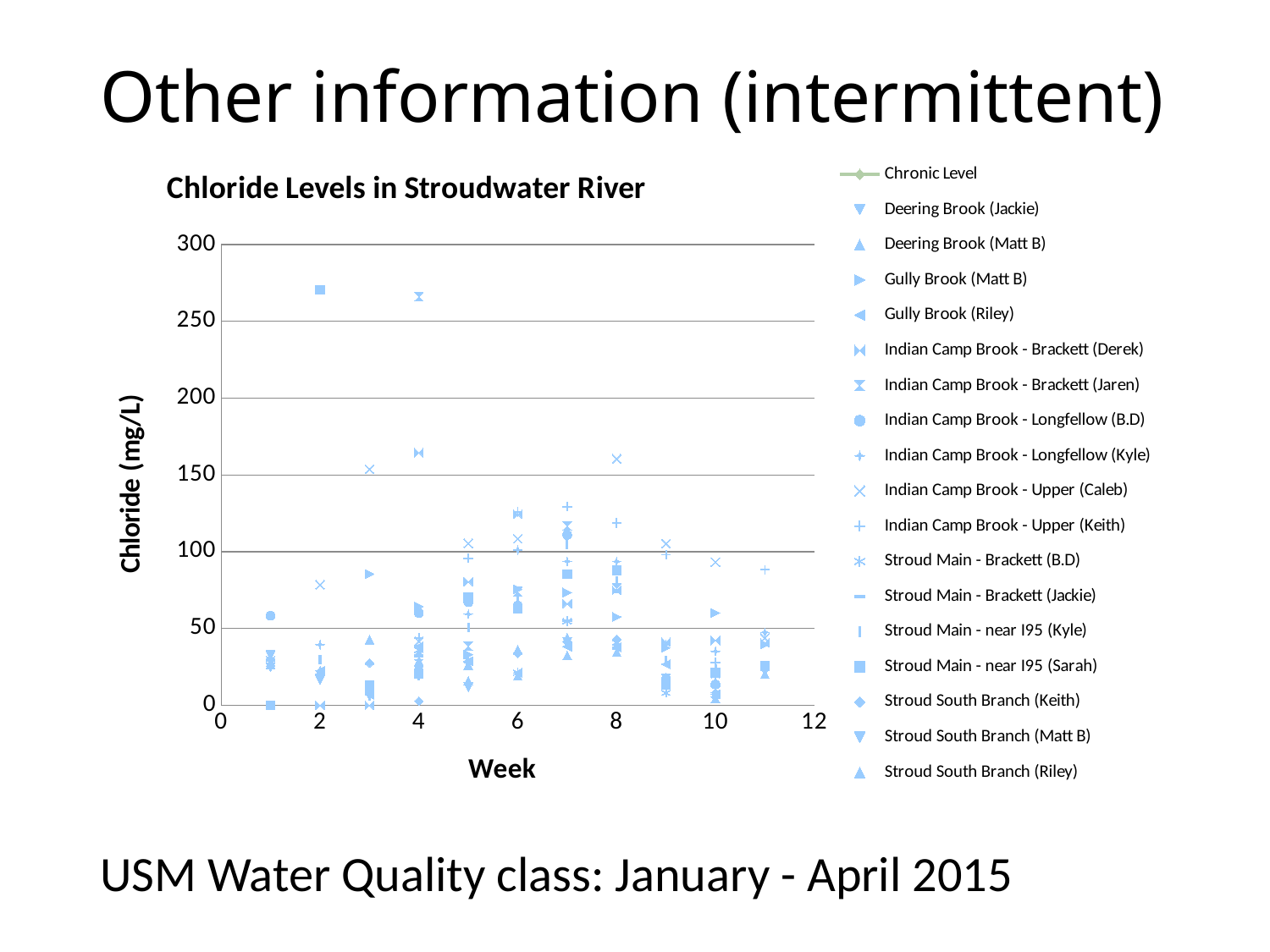
Is the highest plotted value at week 1 greater or less than 100? less What is the maximum value shown on the vertical axis of the chart? 300 Is the highest plotted value at week 10 greater or less than 100? less What is the title of the chart? Chloride Levels in Stroudwater River How many series does the legend of the chart list? 18 Is the highest plotted value at week 11 greater or less than 100? less What kind of chart is shown on the slide? scatter chart What is the label of the vertical axis of the chart? Chloride (mg/L)